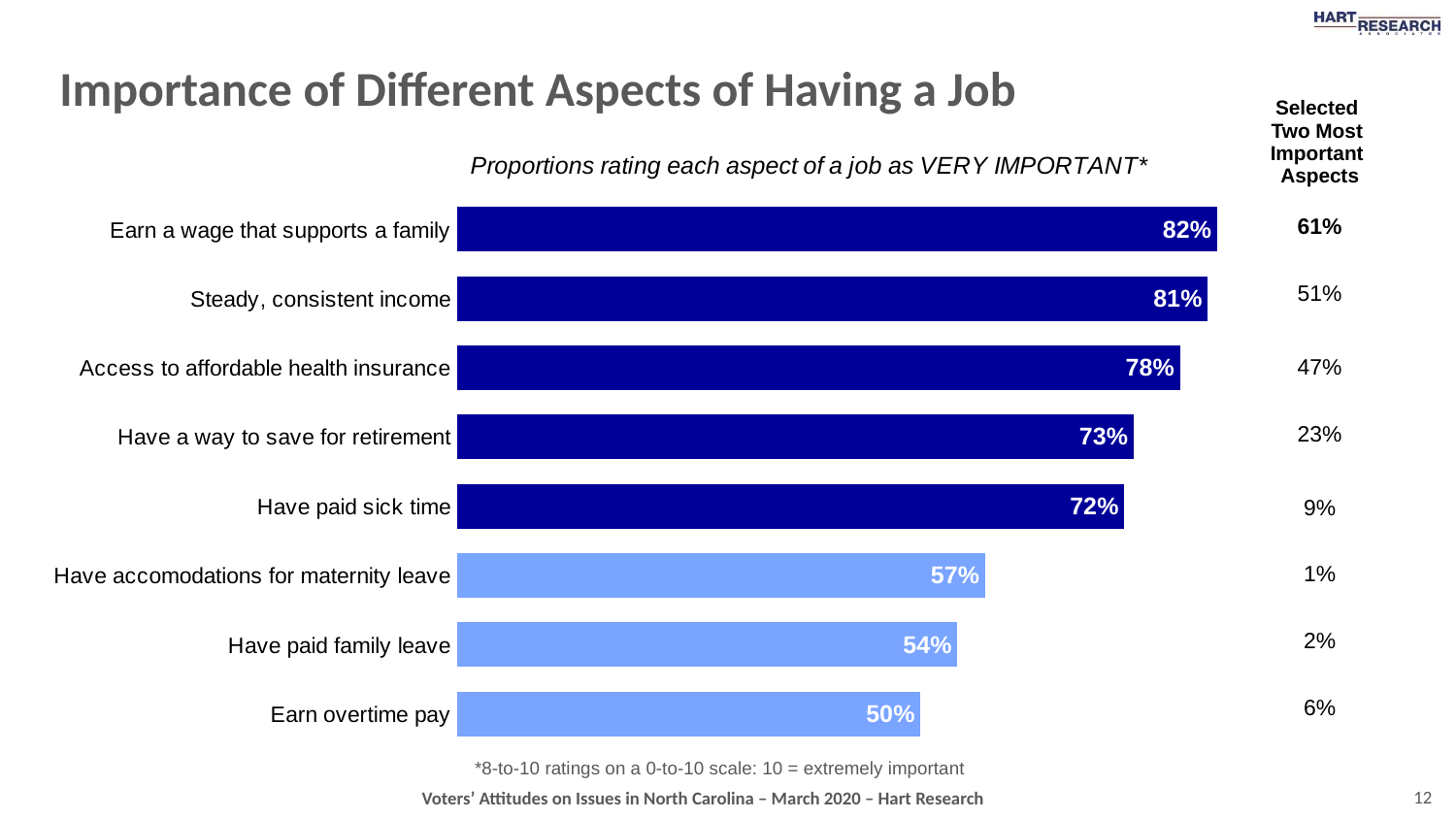
What percentage selected 'Steady, consistent income' as one of the two most important aspects? 51% Which aspect has the highest proportion rating it as very important? Earn a wage that supports a family Which aspect has the lowest proportion rating it as very important? Earn overtime pay Do the very important ratings rise or fall going from the top bar to the bottom bar? Fall What percentage rated 'Earn a wage that supports a family' as very important? 82% Which has a higher very important rating: 'Have a way to save for retirement' or 'Have accomodations for maternity leave'? Have a way to save for retirement What percentage rated 'Earn overtime pay' as very important? 50% What is the subtitle of the chart? Proportions rating each aspect of a job as VERY IMPORTANT* How many job aspects are shown in the bar chart? 8 What percentage rated 'Have paid sick time' as very important? 72% What type of chart is shown on the slide? Bar chart What is the difference between the very important ratings for 'Access to affordable health insurance' and 'Have paid family leave'? 24 percentage points